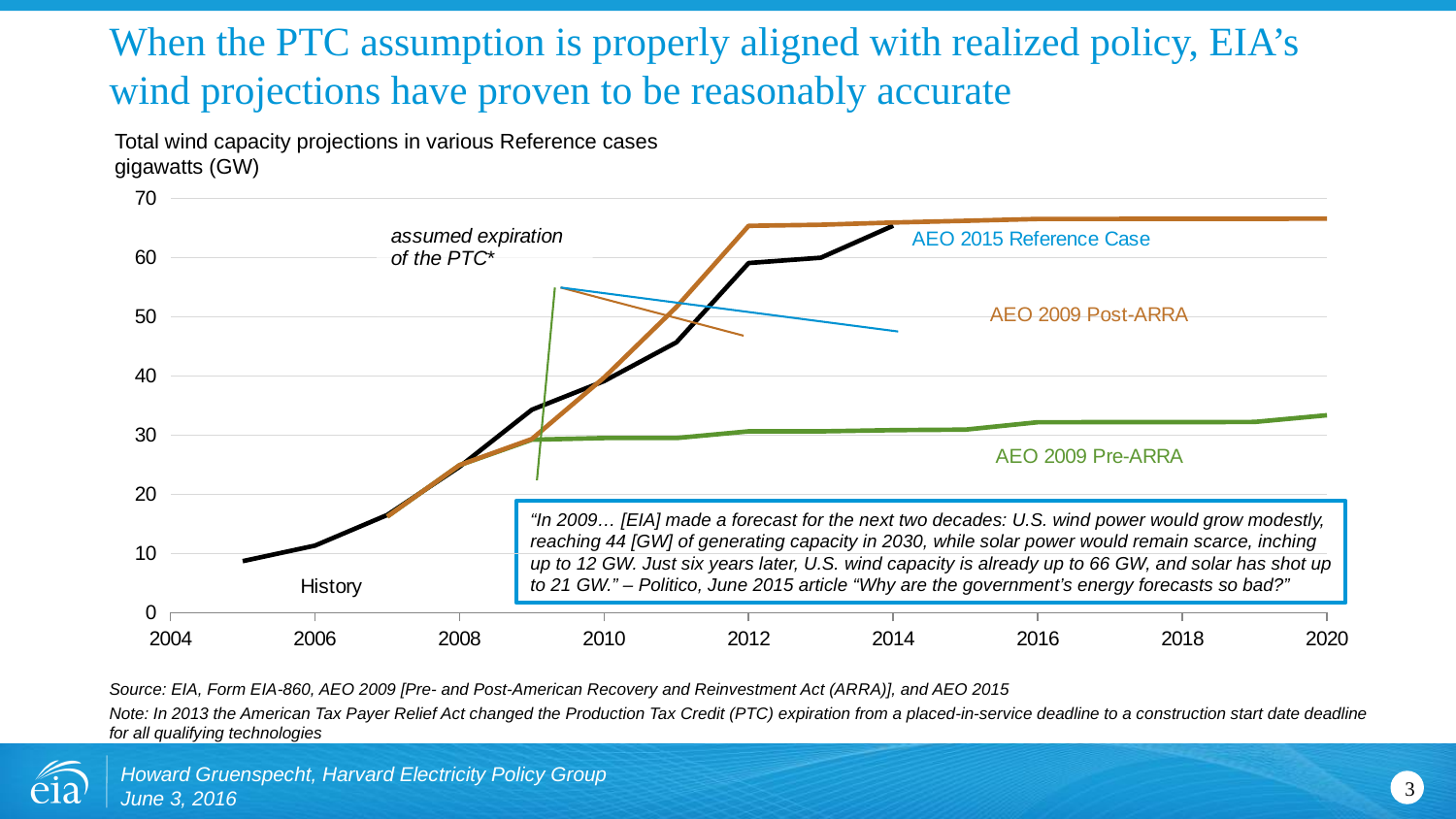
What is the title of the chart? Total wind capacity projections in various Reference cases In 2020, which is larger: the AEO 2015 Reference Case or the AEO 2009 Pre-ARRA projection? AEO 2015 Reference Case Is the History value in 2014 greater or less than 60? greater Does the History line rise or fall between 2005 and 2014? rise Is the AEO 2015 Reference Case value in 2020 greater or less than 60? greater In what unit is wind capacity measured on the chart's y axis? gigawatts (GW) Is the AEO 2009 Pre-ARRA value in 2020 greater or less than 40? less Which series has the lowest value in 2020? AEO 2009 Pre-ARRA What kind of chart is shown on the slide? line chart